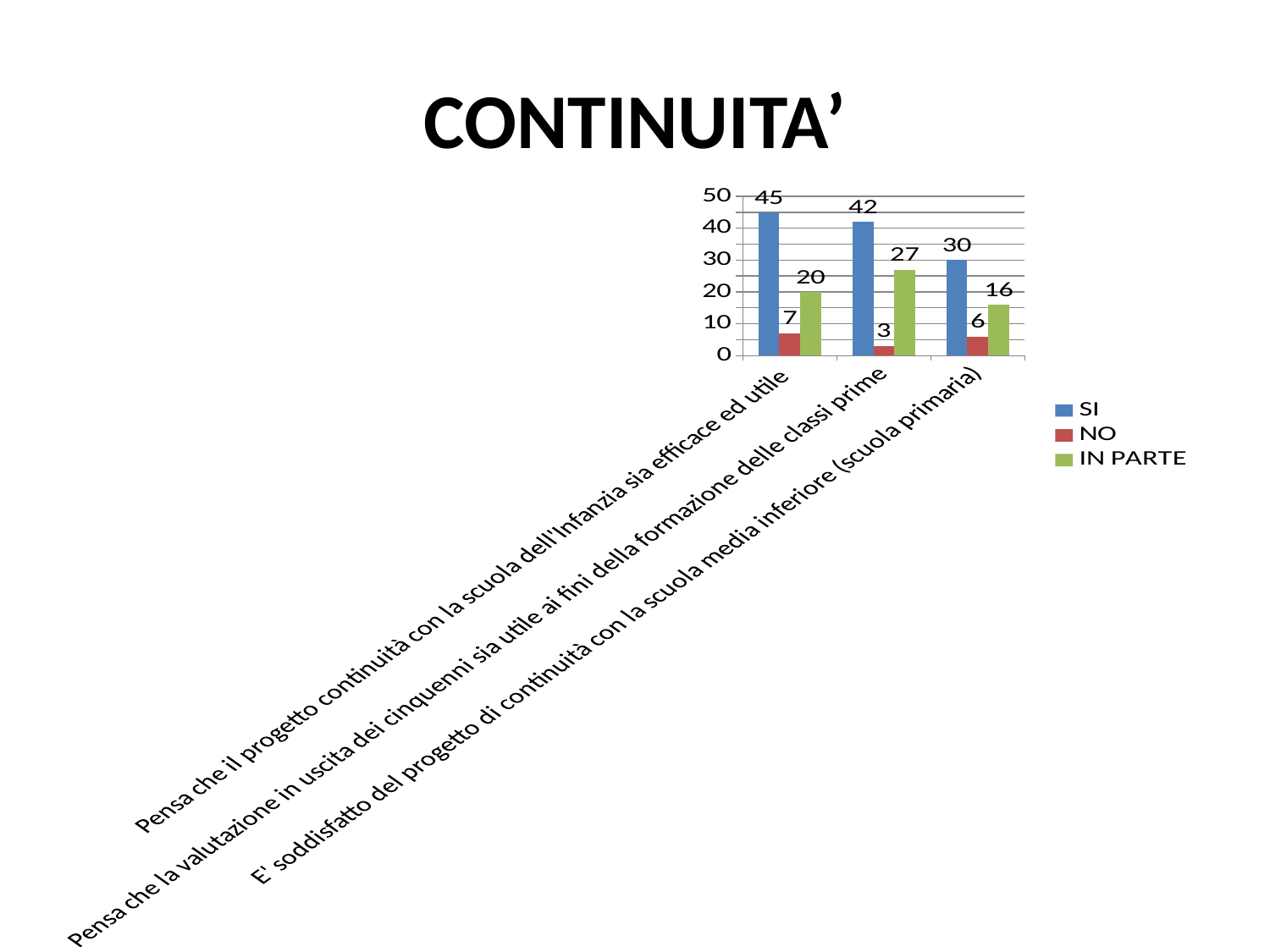
What is the IN PARTE value for "E' soddisfatto del progetto di continuità con la scuola media inferiore (scuola primaria)"? 16 Do the SI values rise or fall across the three categories from left to right? Fall What is the SI value for "Pensa che il progetto continuità con la scuola dell'Infanzia sia efficace ed utile"? 45 What is the NO value for "Pensa che la valutazione in uscita dei cinquenni sia utile ai fini della formazione delle classi prime"? 3 What is the title of the slide? CONTINUITA' Which category has the lowest NO value? Pensa che la valutazione in uscita dei cinquenni sia utile ai fini della formazione delle classi prime Which category has the highest SI value? Pensa che il progetto continuità con la scuola dell'Infanzia sia efficace ed utile How many categories are shown on the x axis? 3 Which is larger: the IN PARTE value for the second category or the IN PARTE value for the first category? The second category (27) How many series does the legend list? 3 What kind of chart is shown on the slide? Bar chart What is the difference between the SI and IN PARTE values for "E' soddisfatto del progetto di continuità con la scuola media inferiore (scuola primaria)"? 14